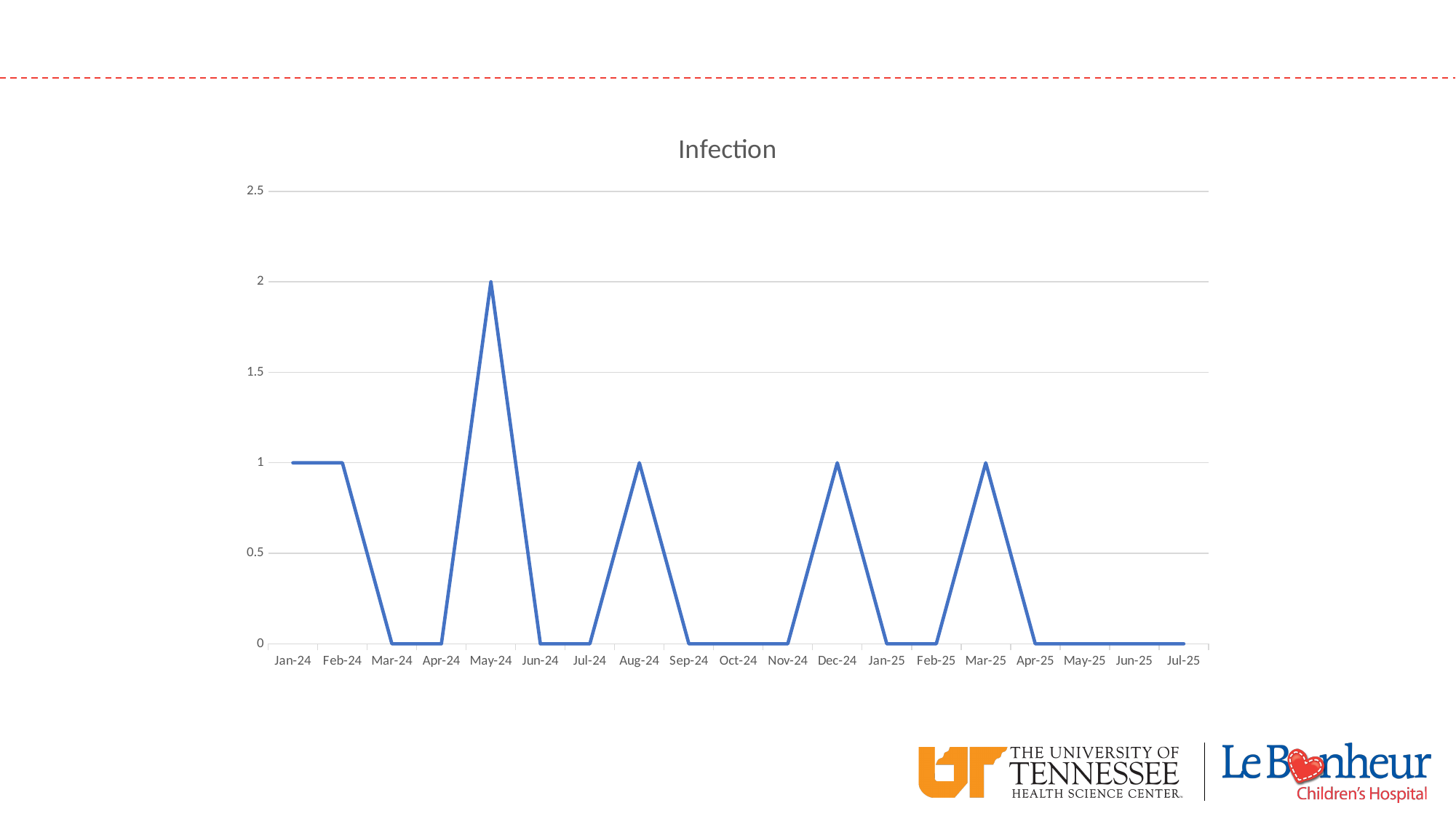
Which is larger, the value for May-24 or the value for Mar-25? May-24 What is the value for May-24? 2 What is the title of the chart? Infection Do the values rise or fall from Mar-25 to Apr-25? fall What is the value for Jul-25? 0 How many months are plotted along the x axis? 19 Is the value for May-24 greater or less than 1.5? greater Which month has the highest value? May-24 What kind of chart is shown on the slide? line chart What is the value for Aug-24? 1 What is the difference between the values for May-24 and Dec-24? 1 What is the value for Jan-24? 1